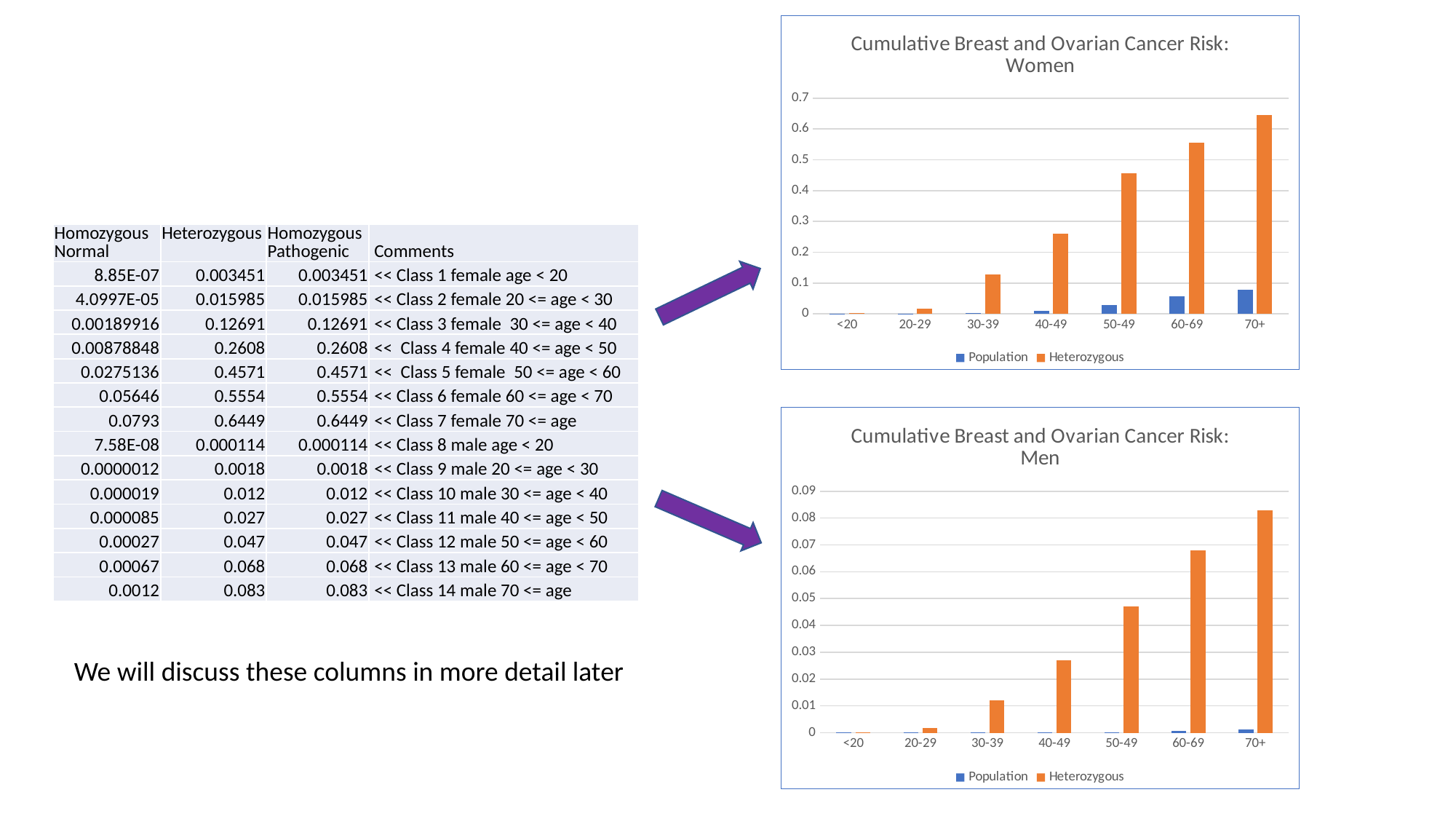
In the 'Cumulative Breast and Ovarian Cancer Risk: Women' chart, is the Heterozygous value for 70+ greater or less than 0.6? greater In the 'Cumulative Breast and Ovarian Cancer Risk: Men' chart, which age category has the lowest Heterozygous value? <20 In the 'Cumulative Breast and Ovarian Cancer Risk: Men' chart, is the Heterozygous value for 70+ greater or less than 0.07? greater In the 'Cumulative Breast and Ovarian Cancer Risk: Women' chart, which age category has the highest Heterozygous value? 70+ What type of chart is the 'Cumulative Breast and Ovarian Cancer Risk: Women' chart? bar chart How many age categories are shown on the x axis of the 'Cumulative Breast and Ovarian Cancer Risk: Women' chart? 7 How many series does the legend of the 'Cumulative Breast and Ovarian Cancer Risk: Men' chart list? 2 In the 'Cumulative Breast and Ovarian Cancer Risk: Women' chart, which is larger for the 60-69 category, the Population value or the Heterozygous value? Heterozygous In the 'Cumulative Breast and Ovarian Cancer Risk: Men' chart, is the Heterozygous value for 50-49 greater or less than 0.05? less In the 'Cumulative Breast and Ovarian Cancer Risk: Men' chart, do the Heterozygous values rise or fall as age increases along the x axis? rise What colour are the Heterozygous bars in the 'Cumulative Breast and Ovarian Cancer Risk: Women' chart? orange